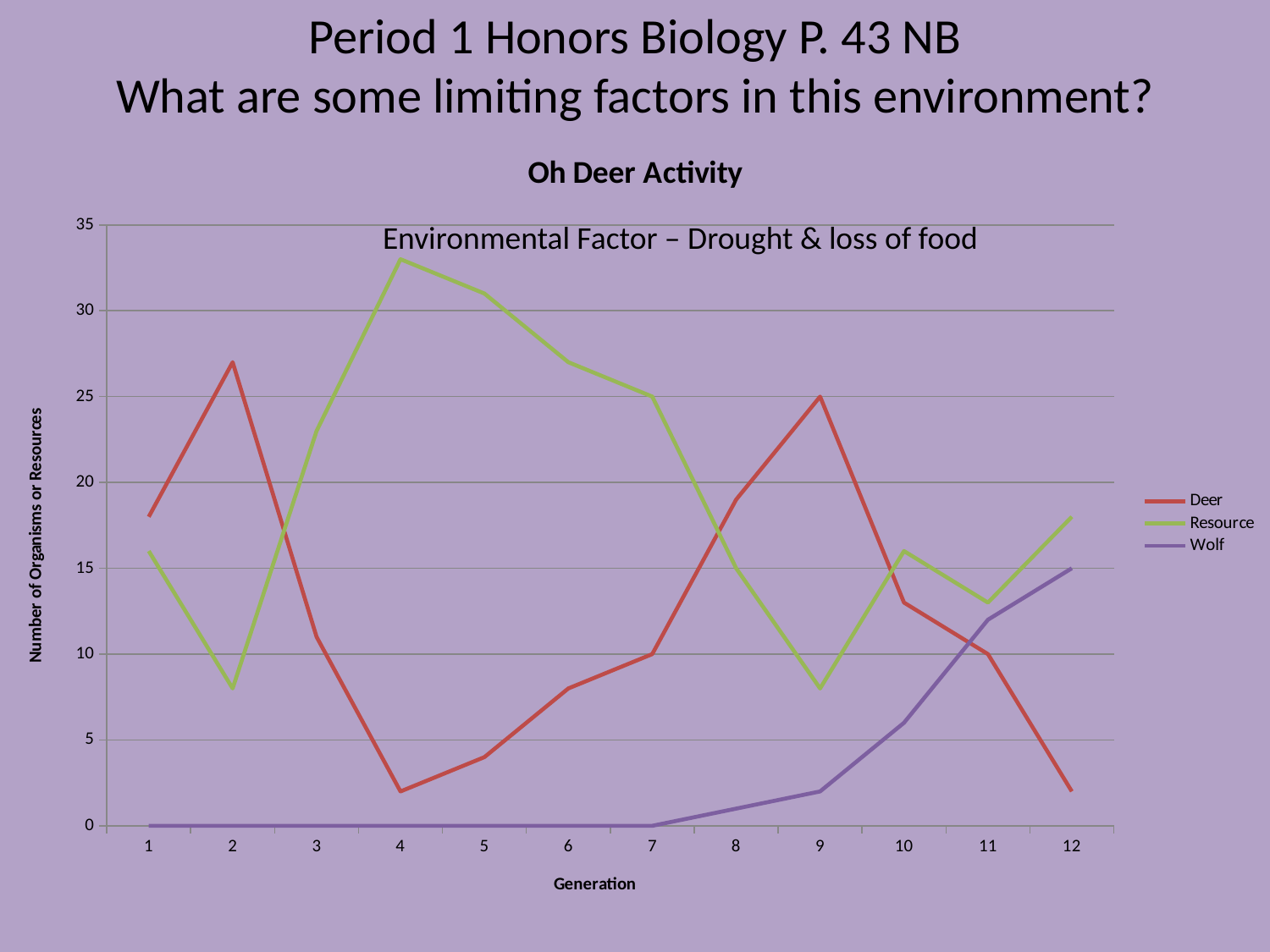
Is the Resource value at generation 4 greater or less than 30? greater What is the Wolf value at generation 1? 0 How many generations are plotted along the x axis? 12 How many series does the legend list? 3 What kind of chart is shown on the slide? Line chart Does the Wolf series rise or fall from generation 7 to generation 12? Rise At generation 4, which is larger, the Deer value or the Resource value? Resource Is the Deer value at generation 4 greater or less than 5? less At which generation does the Resource series reach its highest value? 4 What is the Deer value at generation 9? 25 What is the Deer value at generation 7? 10 At which generation does the Deer series reach its highest value? 2